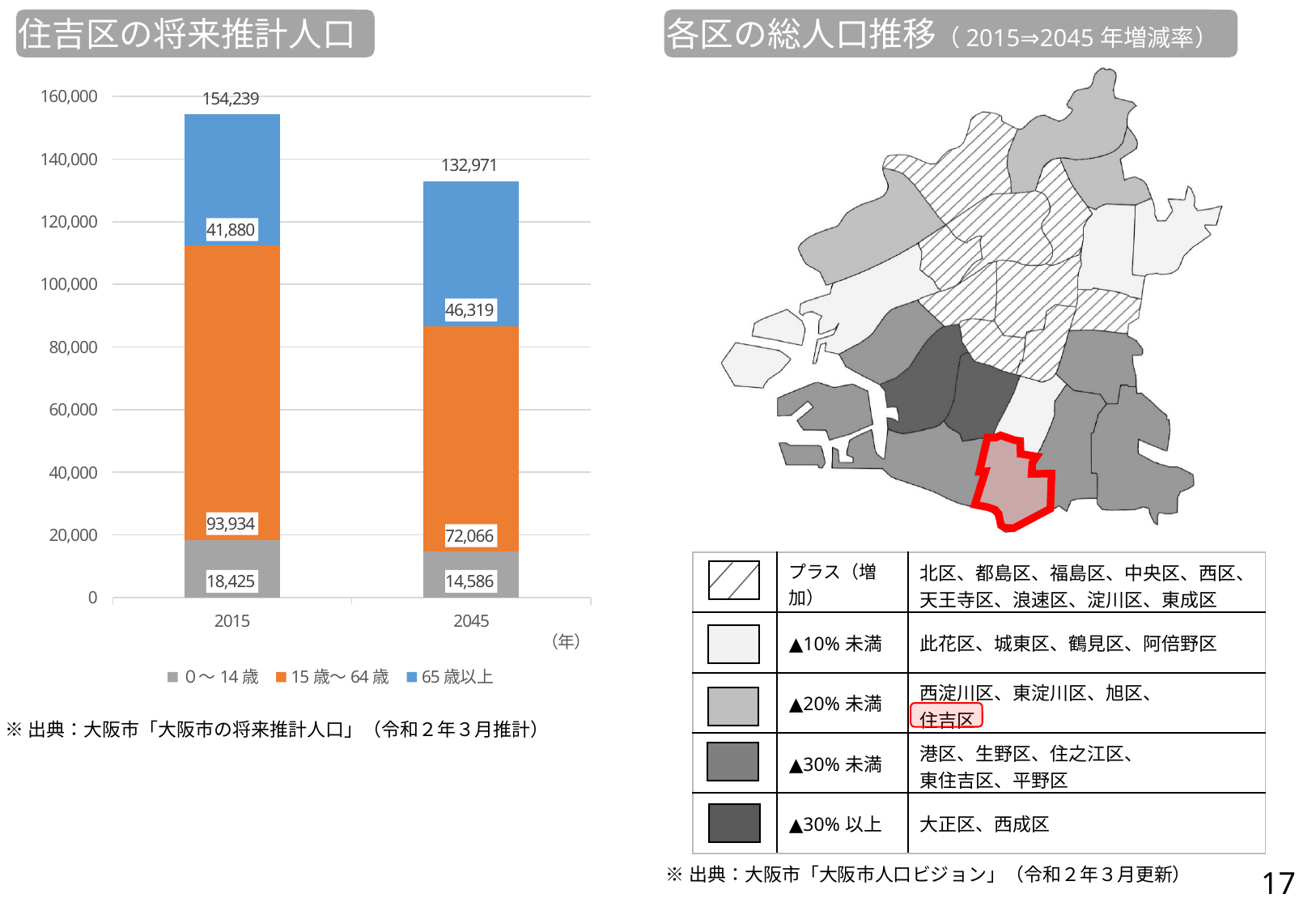
In the 住吉区の将来推計人口 chart, what is the total of the stacked bar for 2045? 132,971 In the 住吉区の将来推計人口 chart, does the total population rise or fall from 2015 to 2045? Fall In the 住吉区の将来推計人口 chart, which year has the larger 65歳以上 value, 2015 or 2045? 2045 In the 住吉区の将来推計人口 chart, which year has the lower 0～14歳 value? 2045 In the 住吉区の将来推計人口 chart, what is the difference between the 15歳～64歳 values for 2015 and 2045? 21,868 In the 住吉区の将来推計人口 chart, what is the value for 0～14歳 in 2015? 18,425 In the 住吉区の将来推計人口 chart, what is the total of the stacked bar for 2015? 154,239 In the 住吉区の将来推計人口 chart, what is the value for 15歳～64歳 in 2015? 93,934 In the 住吉区の将来推計人口 chart, how many years are shown on the x axis? 2 What kind of chart is the 住吉区の将来推計人口 chart? Stacked bar chart In the 住吉区の将来推計人口 chart, what is the value for 65歳以上 in 2045? 46,319 In the 住吉区の将来推計人口 chart, how many series does the legend list? 3